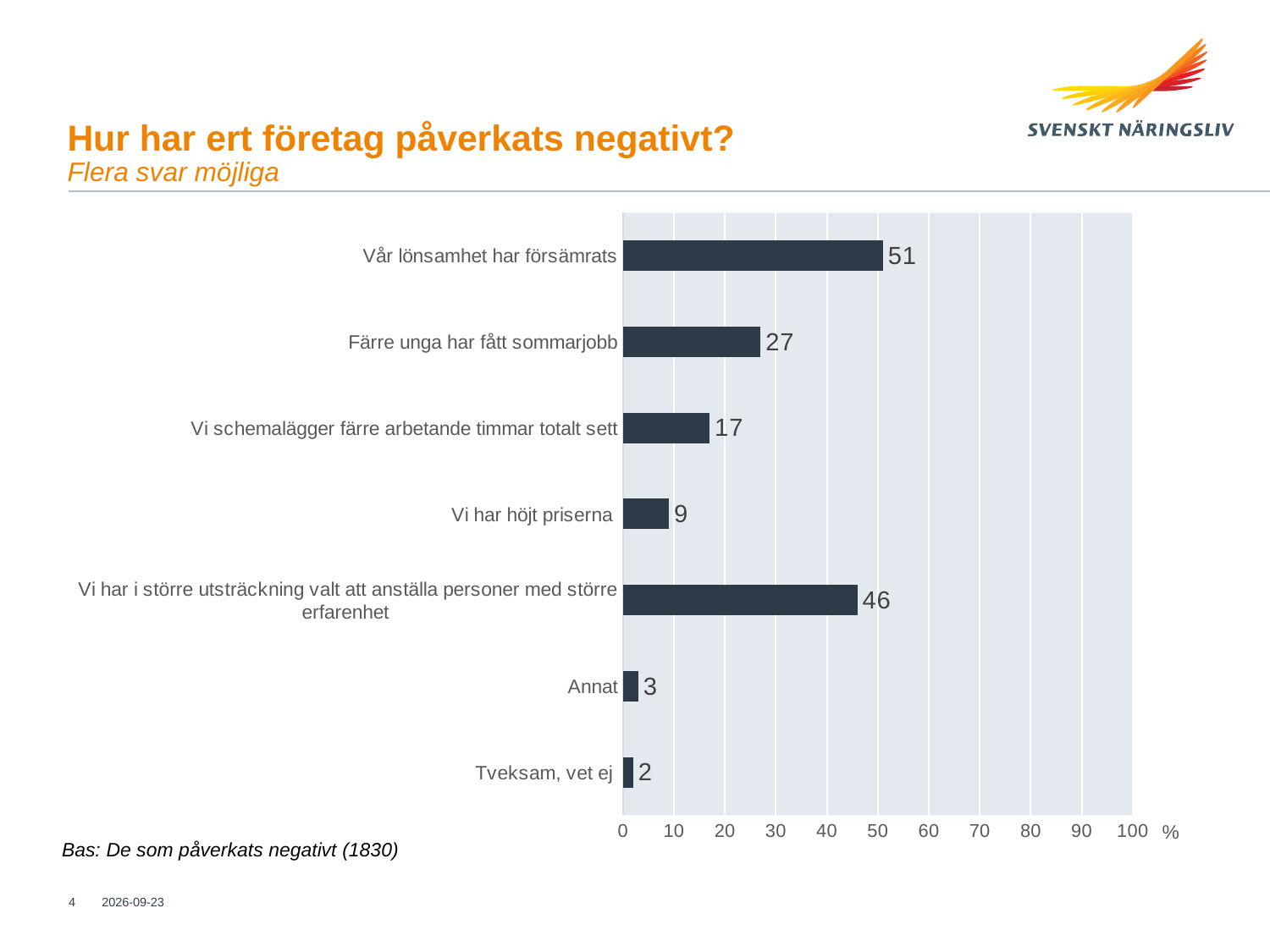
Which category has the highest value? Vår lönsamhet har försämrats Is the value for "Vi har i större utsträckning valt att anställa personer med större erfarenhet" greater or less than 40? greater Which is larger: the value for "Vi schemalägger färre arbetande timmar totalt sett" or the value for "Vi har höjt priserna"? Vi schemalägger färre arbetande timmar totalt sett What is the value for "Vår lönsamhet har försämrats"? 51 What is the value for "Färre unga har fått sommarjobb"? 27 What is the value for "Vi har höjt priserna"? 9 What is the value for "Vi har i större utsträckning valt att anställa personer med större erfarenhet"? 46 What is the title of the slide? Hur har ert företag påverkats negativt? What kind of chart is shown on the slide? bar chart How many categories are shown in the chart? 7 What is the difference between the values for "Vår lönsamhet har försämrats" and "Färre unga har fått sommarjobb"? 24 Which category has the lowest value? Tveksam, vet ej